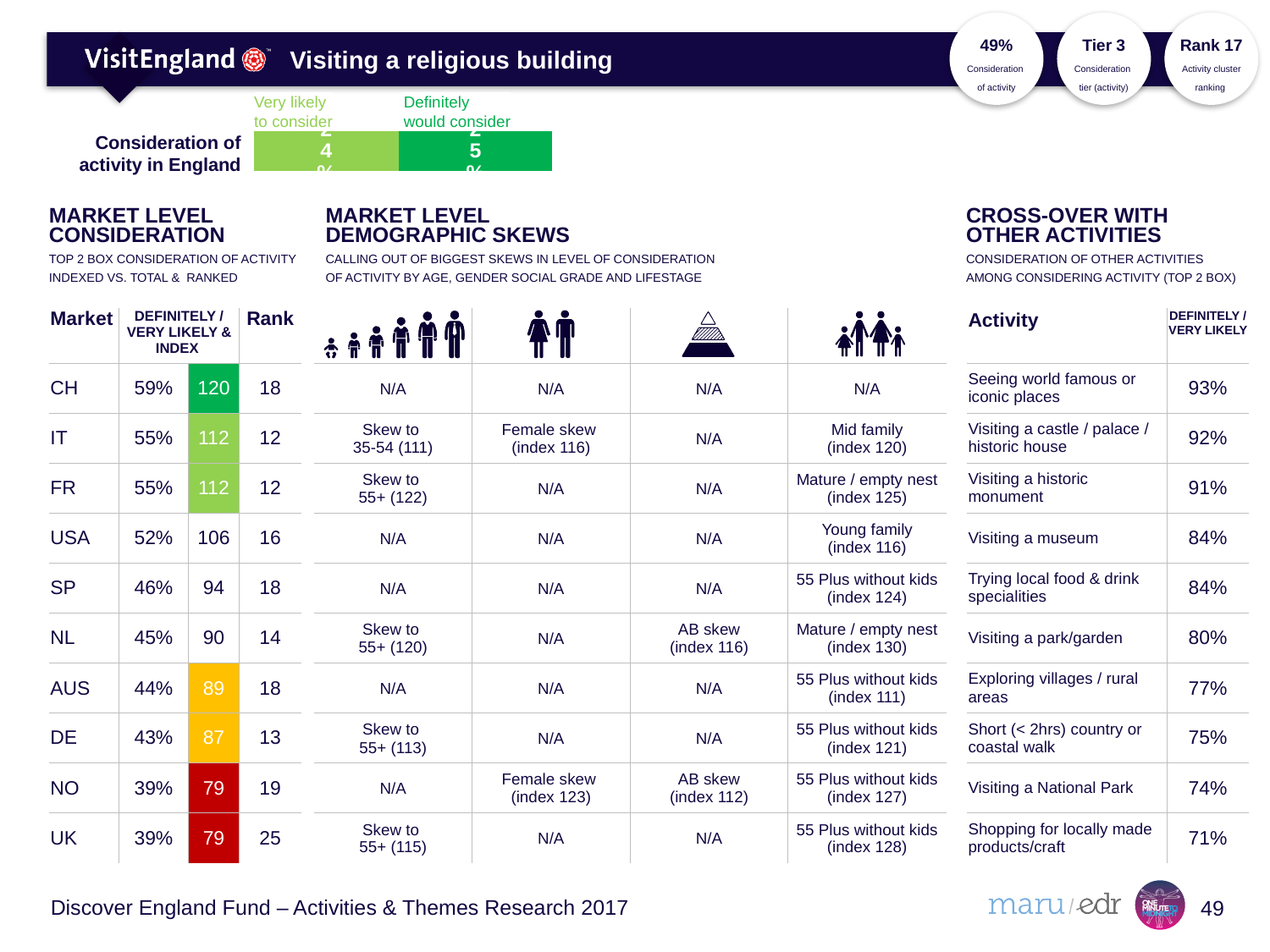
What colour is the 'Definitely would consider' segment in the 'Consideration of activity in England' chart? dark green In the 'Consideration of activity in England' chart, what is the value for 'Very likely to consider'? 24% In the 'Consideration of activity in England' chart, what is the value for 'Definitely would consider'? 25% What is the total of the stacked 'Consideration of activity in England' bar? 49% How many series does the 'Consideration of activity in England' chart show? 2 What kind of chart is the 'Consideration of activity in England' chart? bar chart In the 'Consideration of activity in England' chart, which segment is larger: 'Very likely to consider' or 'Definitely would consider'? Definitely would consider What are the two series labels shown above the 'Consideration of activity in England' bar? Very likely to consider; Definitely would consider